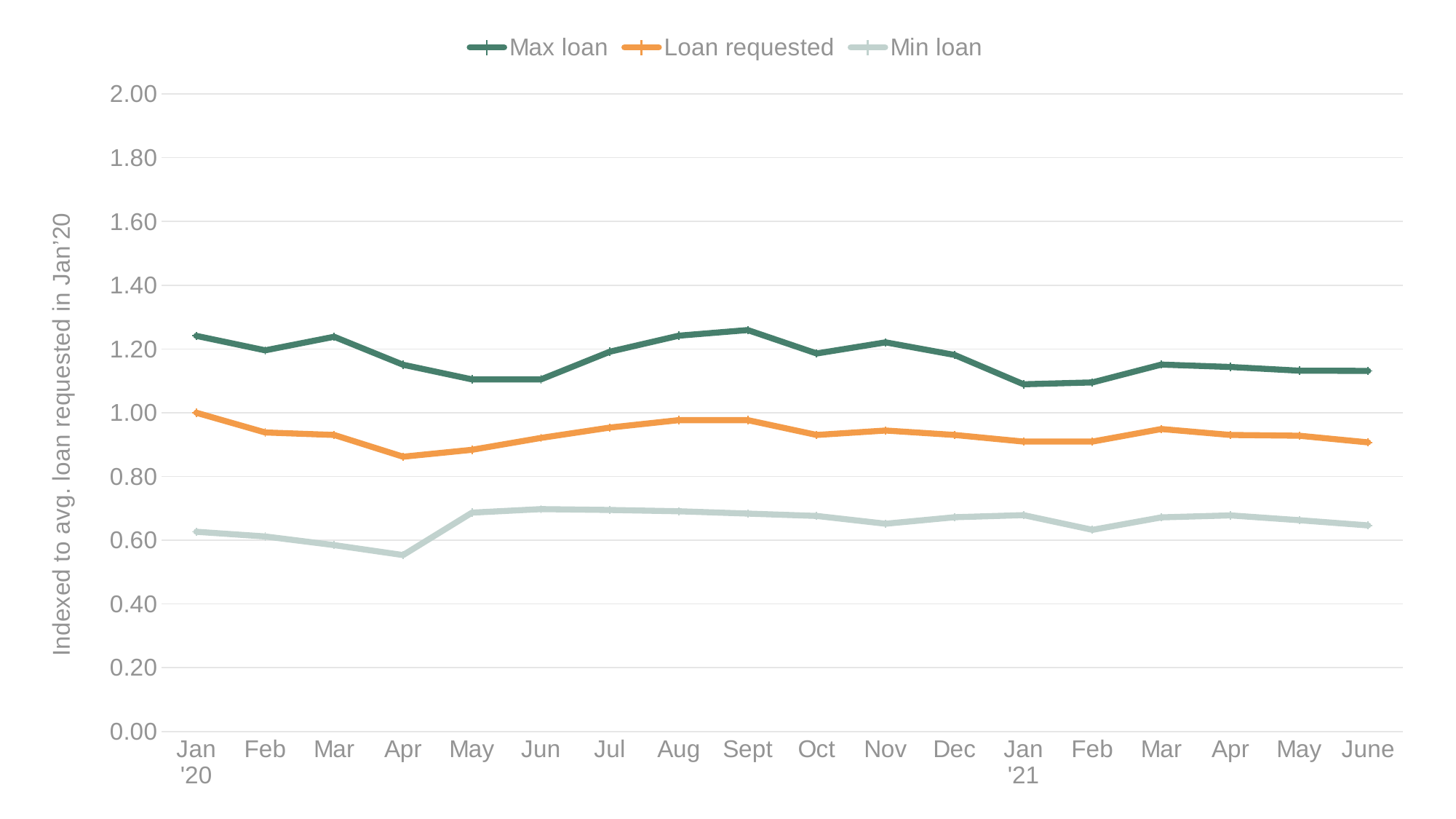
How many series does the legend list? 3 In which month is the Loan requested series at its highest? Jan '20 In which month is the Min loan series at its lowest? Apr '20 Is the value for Max loan in Sept greater or less than 1.20? greater How many months are plotted along the x axis? 18 Which is larger in Jan '20, Max loan or Min loan? Max loan What is the label on the y axis? Indexed to avg. loan requested in Jan'20 What is the value of Loan requested in Jan '20? 1.00 What kind of chart is shown on the slide? Line chart Is the value for Min loan in Apr '20 greater or less than 0.60? less Is the value for Loan requested in Apr '20 greater or less than 0.90? less Does the Loan requested series rise or fall from Jan '20 to Apr '20? Fall